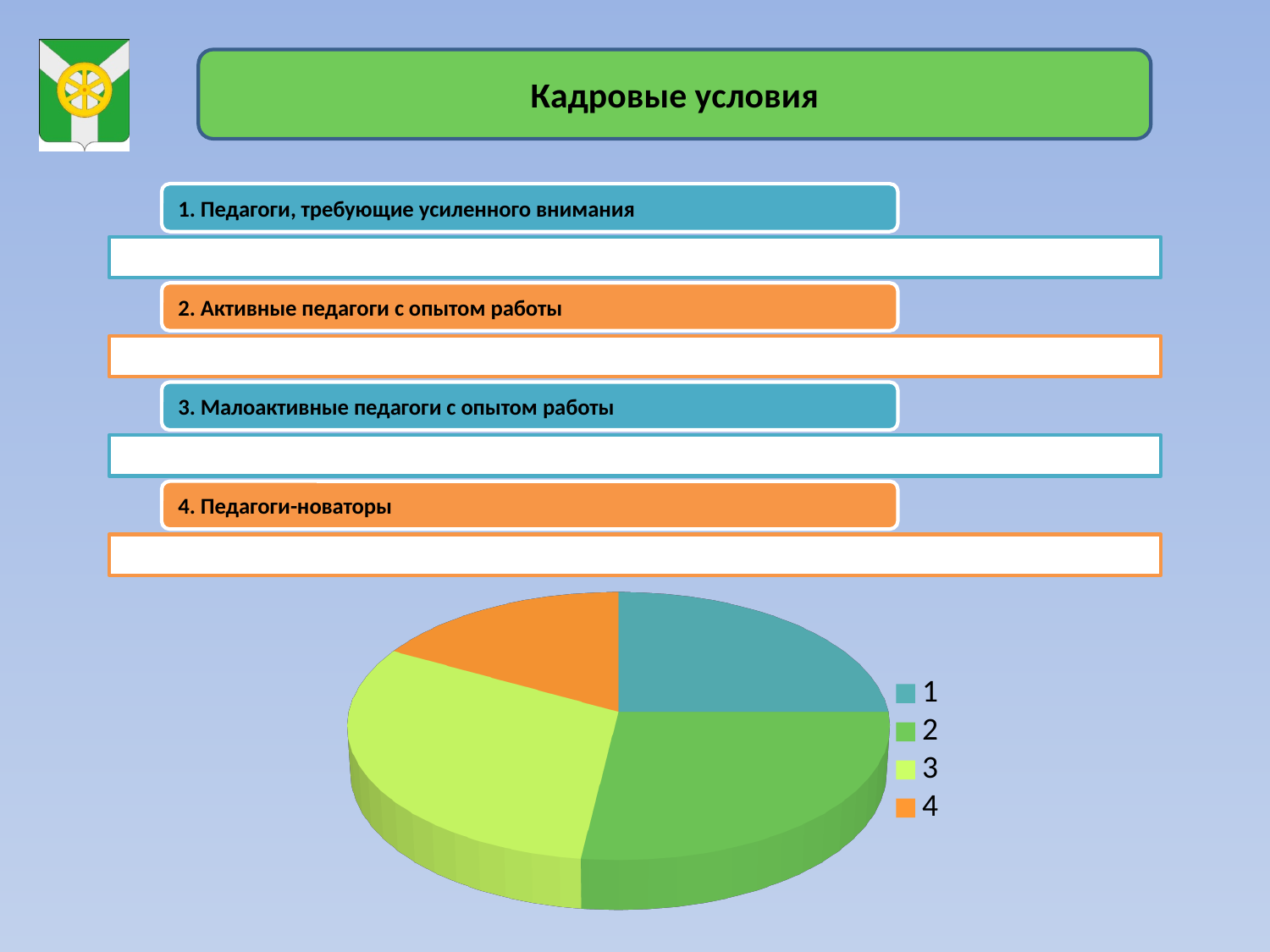
Which slice is larger in the pie chart, 3 or 4? 3 How many entries does the legend of the pie chart list? 4 Which slice is larger in the pie chart, 2 or 4? 2 Which slice of the pie chart is the smallest? 4 What are the legend entries of the pie chart? 1, 2, 3, 4 What colour is slice 4 in the pie chart? orange How many slices does the pie chart have? 4 Which slice is larger in the pie chart, 1 or 4? 1 What kind of chart is shown on the slide? pie chart